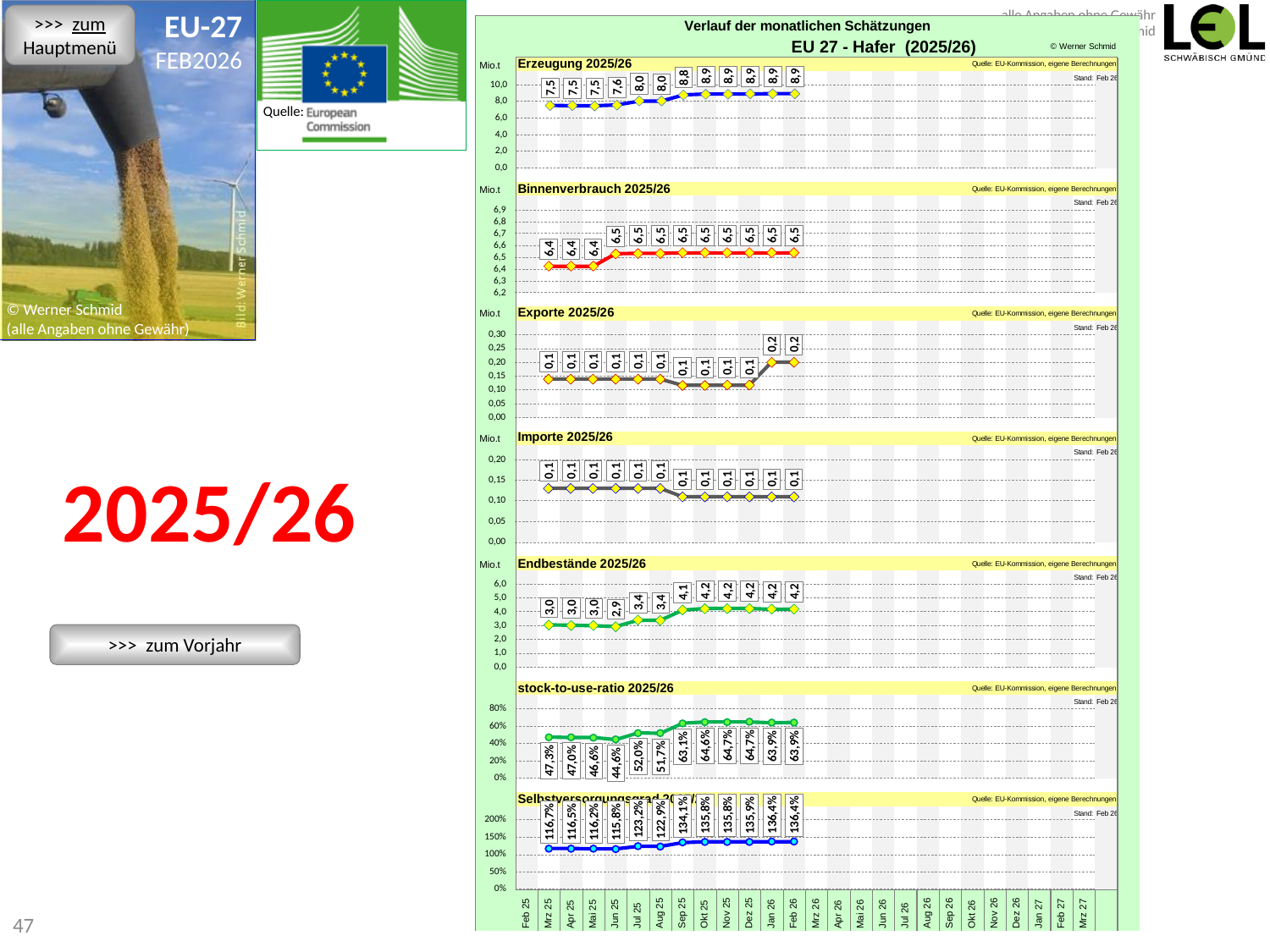
In the Erzeugung 2025/26 chart, what is the value for Mrz 25? 7,5 In the Erzeugung 2025/26 chart, what is the value for Feb 26? 8,9 In the Endbestände 2025/26 chart, which month has the lowest value? Jun 25 In the Exporte 2025/26 chart, what is the value for Jan 26? 0,2 What kind of chart is used in the Erzeugung 2025/26 panel? line chart In the stock-to-use-ratio 2025/26 chart, what is the value for Feb 26? 63,9% In the Erzeugung 2025/26 chart, what is the difference between the Feb 26 value and the Mrz 25 value? 1,4 In the stock-to-use-ratio 2025/26 chart, which month has the lowest value? Jun 25 In the Endbestände 2025/26 chart, what is the value for Jun 25? 2,9 In the Selbstversorgungsgrad chart at the bottom, what is the value for Feb 26? 136,4% In the Erzeugung 2025/26 chart, do the values rise or fall from Mrz 25 to Feb 26? rise In the Binnenverbrauch 2025/26 chart, is the value for Feb 26 larger or smaller than the value for Mrz 25? larger